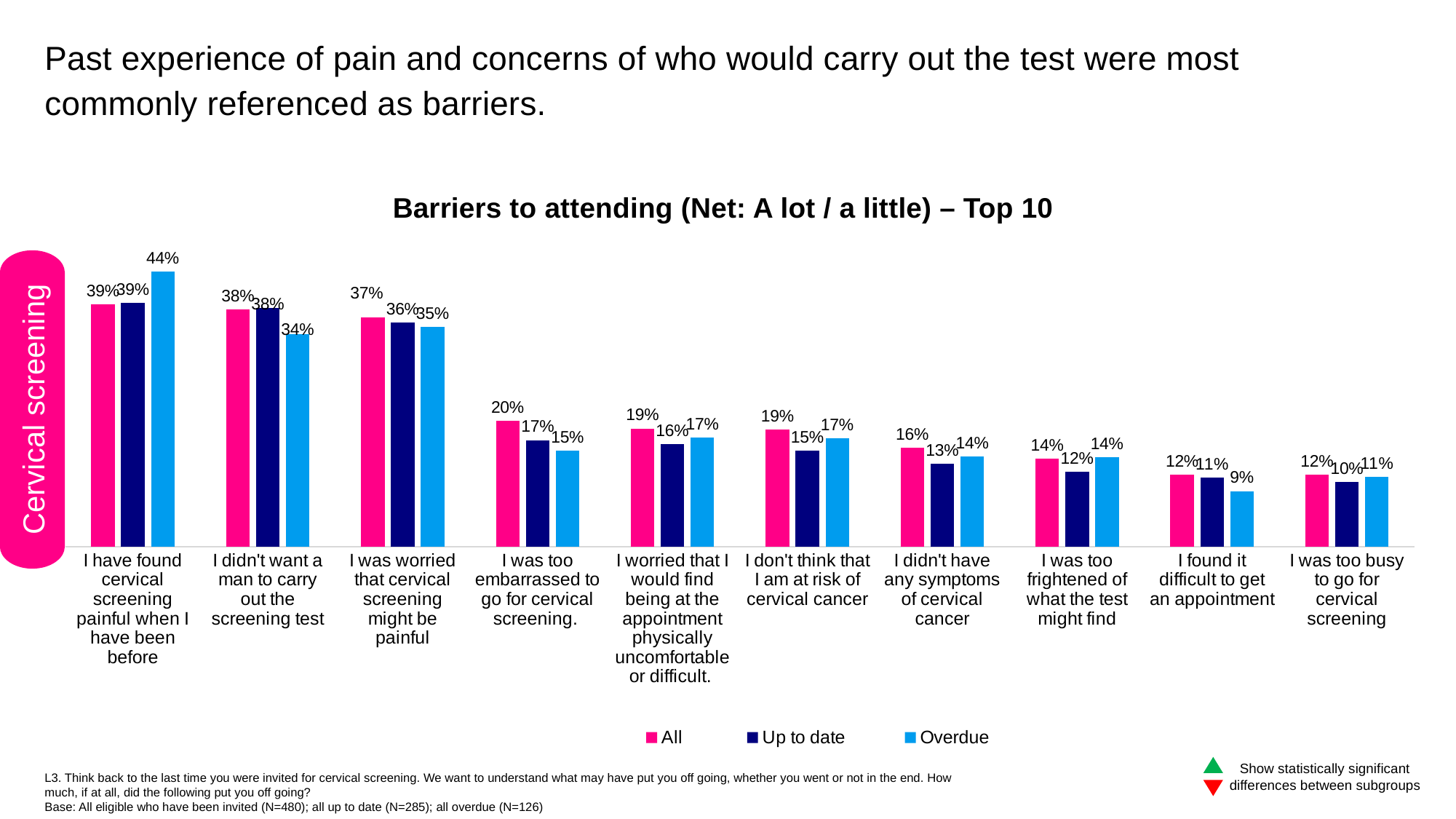
Which category has the highest Overdue value? I have found cervical screening painful when I have been before What is the Overdue value for 'I found it difficult to get an appointment'? 9% How many categories are shown on the x axis? 10 What is the All value for 'I was too embarrassed to go for cervical screening.'? 20% Which category has the lowest Overdue value? I found it difficult to get an appointment What is the title of the chart? Barriers to attending (Net: A lot / a little) – Top 10 What is the difference between the Overdue and Up to date values for 'I have found cervical screening painful when I have been before'? 5% Which is larger for 'I didn't want a man to carry out the screening test': the All value or the Overdue value? All What is the Up to date value for 'I was worried that cervical screening might be painful'? 36% How many series does the legend list? 3 What kind of chart is shown on the slide? Bar chart What is the Overdue value for 'I have found cervical screening painful when I have been before'? 44%